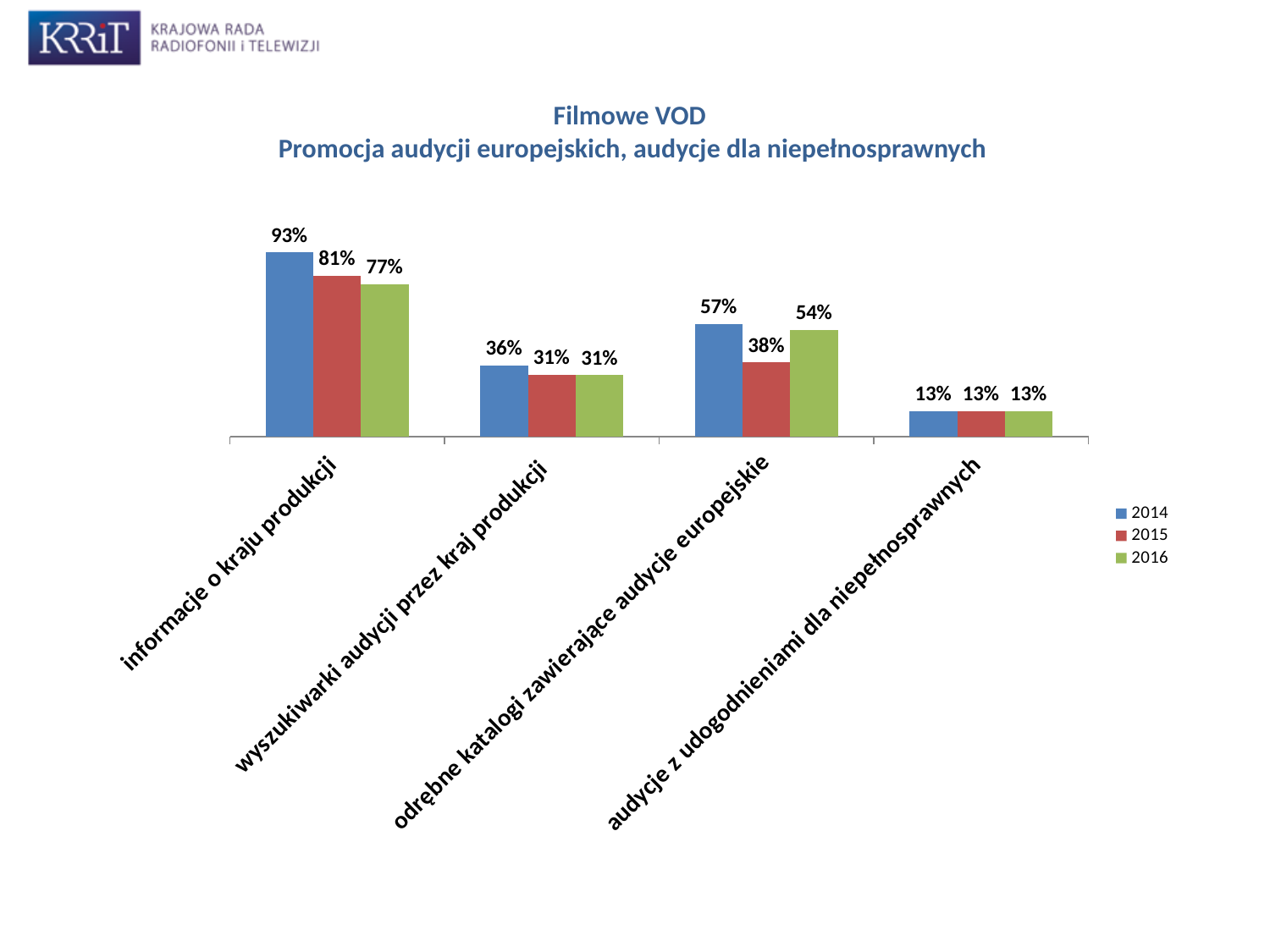
What kind of chart is shown on the slide? bar chart What is the 2016 value for "wyszukiwarki audycji przez kraj produkcji"? 31% Do the values for "informacje o kraju produkcji" rise or fall from 2014 to 2016? fall Which is larger: the 2016 value for "odrębne katalogi zawierające audycje europejskie" or the 2016 value for "wyszukiwarki audycji przez kraj produkcji"? odrębne katalogi zawierające audycje europejskie Which category has the lowest 2016 value? audycje z udogodnieniami dla niepełnosprawnych Which category has the highest 2014 value? informacje o kraju produkcji What is the difference between the 2014 and 2015 values for "odrębne katalogi zawierające audycje europejskie"? 19% How many series does the legend list? 3 What is the difference between the 2014 and 2016 values for "informacje o kraju produkcji"? 16% How many categories are shown on the x axis? 4 What is the 2015 value for "odrębne katalogi zawierające audycje europejskie"? 38% What is the 2014 value for "informacje o kraju produkcji"? 93%